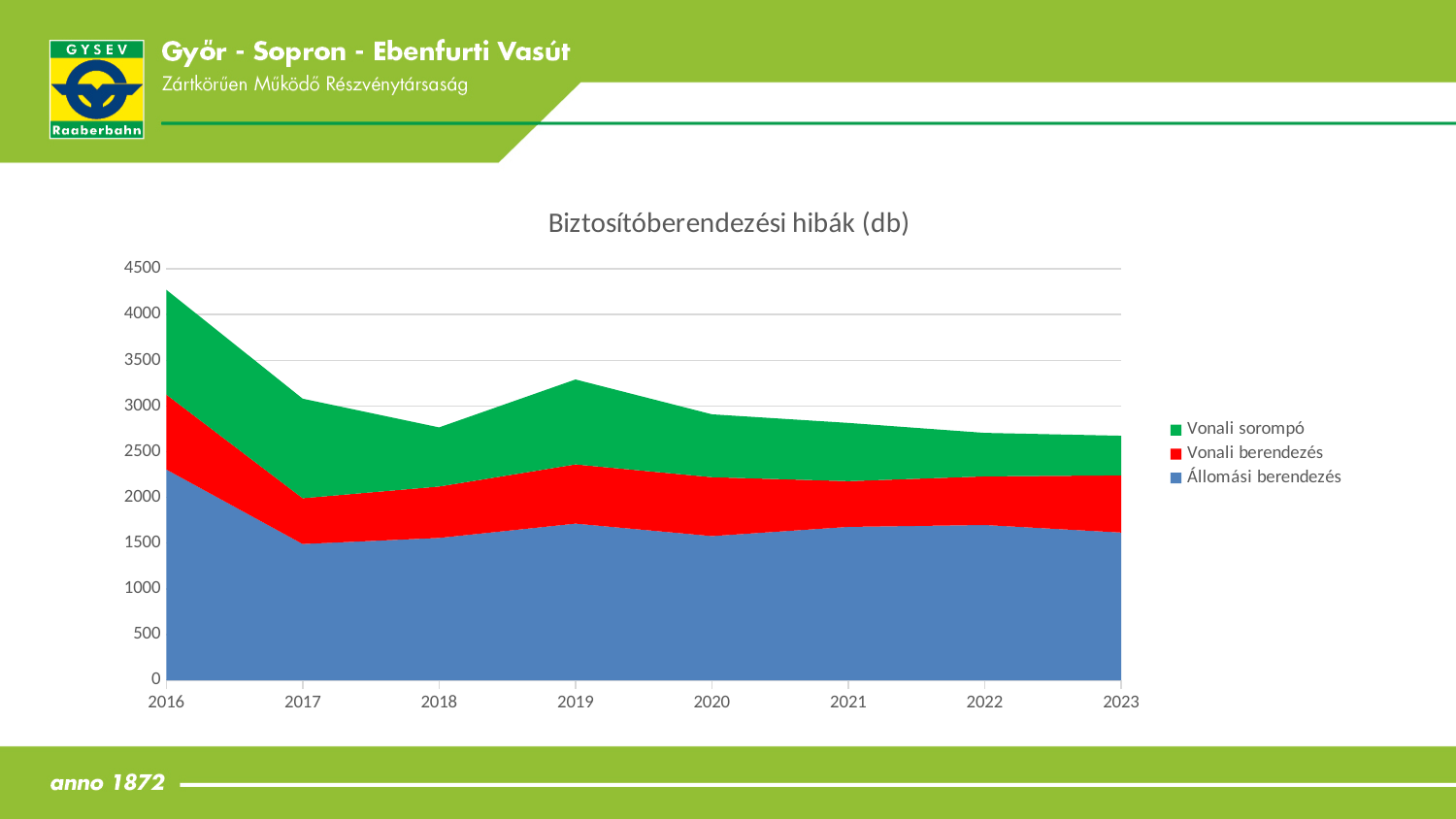
What is the title of the chart? Biztosítóberendezési hibák (db) In which year is the total number of errors (top of the stacked area) highest? 2016 Is the value for Állomási berendezés in 2017 greater or less than 2000? less How many years are shown along the x axis? 8 Is the total value for 2016 greater or less than 4000? greater Which colour represents Vonali sorompó in the chart? Green What kind of chart is shown on the slide? Stacked area chart Is the total value for 2023 greater or less than 3000? less How many series does the legend list? 3 Which year has a larger total, 2016 or 2017? 2016 Does the total number of errors rise or fall from 2016 to 2017? Fall